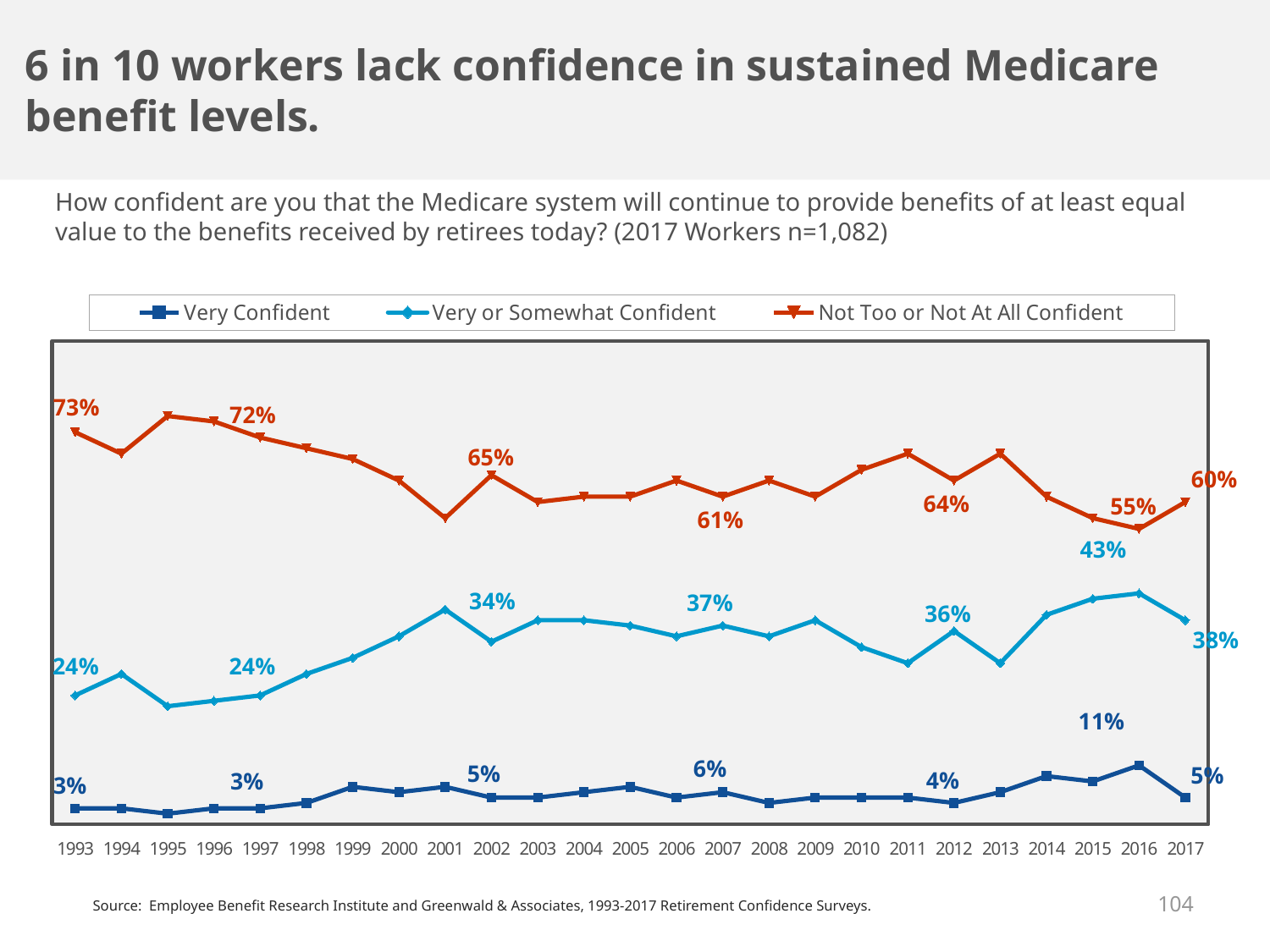
Did the Very Confident value rise or fall from 2016 to 2017? Fall What is the value for Not Too or Not At All Confident in 2017? 60% What is the value for Very or Somewhat Confident in 2016? 43% What is the value for Very Confident in 2016? 11% Which series is drawn in red? Not Too or Not At All Confident What is the difference between the Not Too or Not At All Confident values in 1993 and 2017? 13 percentage points In 2017, which is larger: Very or Somewhat Confident or Not Too or Not At All Confident? Not Too or Not At All Confident How many years are shown on the x axis? 25 What is the difference between the Very Confident values in 2016 and 2017? 6 percentage points What kind of chart is shown on the slide? Line chart How many series does the legend list? 3 What is the value for Very or Somewhat Confident in 2007? 37%